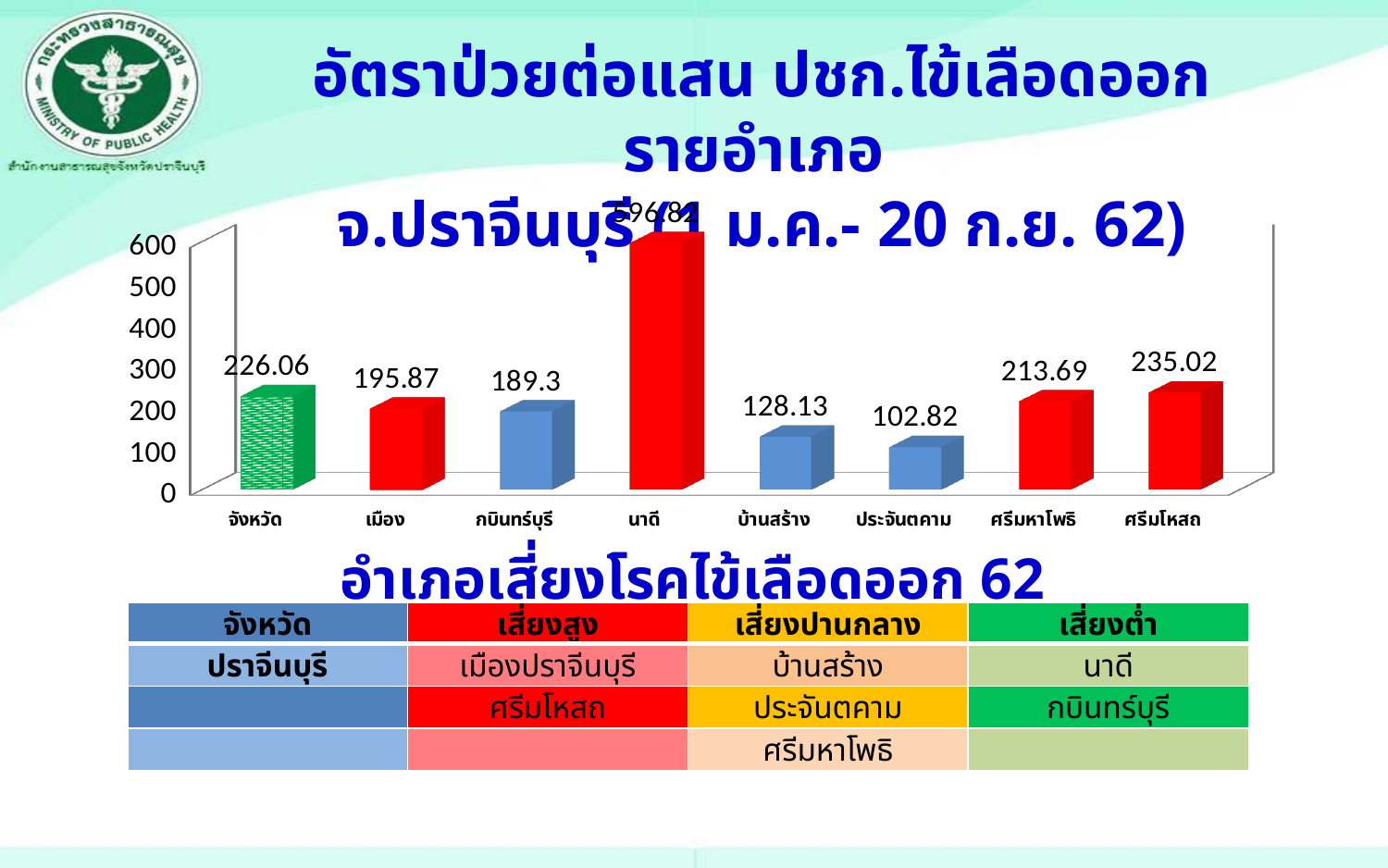
What is the difference between the values for ศรีมโหสถ and ศรีมหาโพธิ? 21.33 Which category has the highest value in the chart? นาดี Is the value for นาดี greater or less than 500? greater Which category has the lowest value in the chart? ประจันตคาม What is the value for จังหวัด in the chart? 226.06 What is the value for เมือง in the chart? 195.87 What is the value for ศรีมโหสถ in the chart? 235.02 What is the value for ประจันตคาม in the chart? 102.82 What is the value for กบินทร์บุรี in the chart? 189.3 How many categories are shown on the x axis of the chart? 8 What is the value for บ้านสร้าง in the chart? 128.13 What type of chart is shown on the slide? bar chart